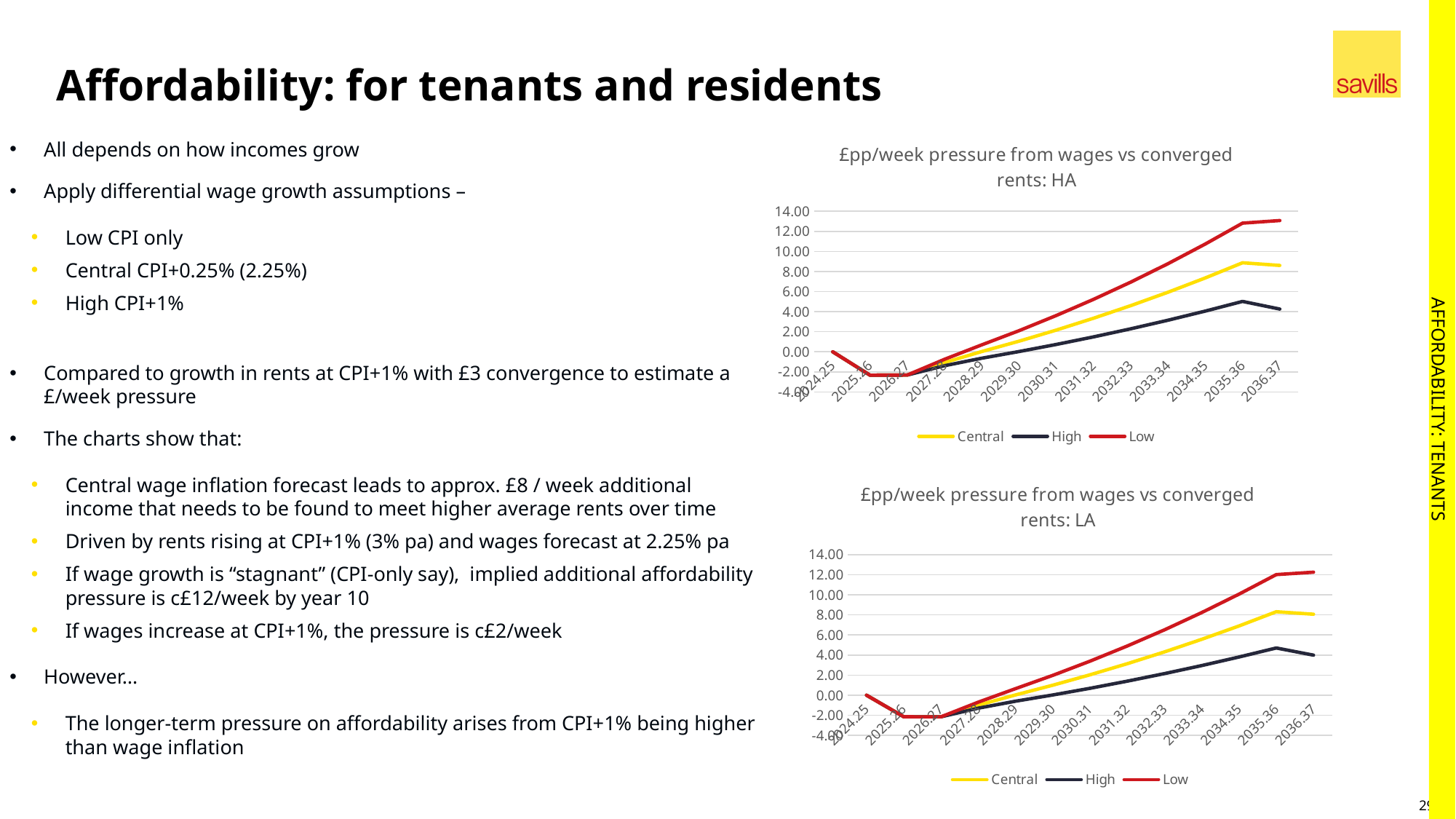
What colour is the Low series line in the '£pp/week pressure from wages vs converged rents: LA' chart? red In the '£pp/week pressure from wages vs converged rents: HA' chart, which is larger at 2034.35, Central or High? Central In the '£pp/week pressure from wages vs converged rents: HA' chart, is the value for Low at 2036.37 greater or less than 12.00? greater In the '£pp/week pressure from wages vs converged rents: LA' chart, is the value for Low at 2036.37 greater or less than 10.00? greater How many years are shown on the x axis of the '£pp/week pressure from wages vs converged rents: HA' chart? 13 In the '£pp/week pressure from wages vs converged rents: HA' chart, is the value for High at 2036.37 greater or less than 6.00? less In the '£pp/week pressure from wages vs converged rents: LA' chart, which series has the lowest value at 2036.37? High In the '£pp/week pressure from wages vs converged rents: HA' chart, which series has the highest value at 2036.37? Low How many series does the legend of the '£pp/week pressure from wages vs converged rents: LA' chart list? 3 What kind of chart is the '£pp/week pressure from wages vs converged rents: HA' chart? line chart In the '£pp/week pressure from wages vs converged rents: HA' chart, does the Low series rise or fall between 2027.28 and 2035.36? rise